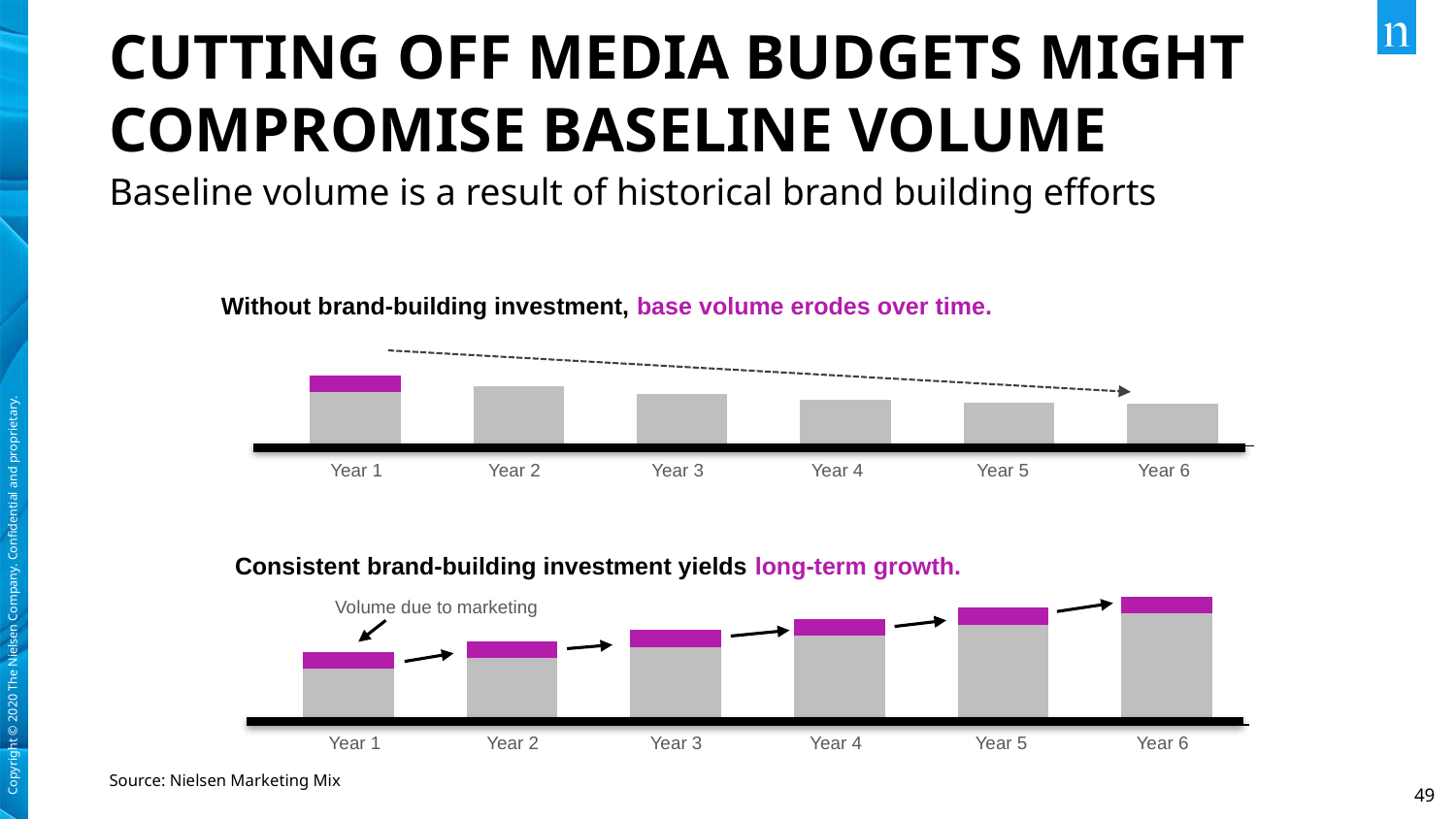
What kind of chart is the bottom chart, titled "Consistent brand-building investment yields long-term growth"? Bar chart In the bottom chart (consistent brand-building investment), do the bars rise or fall from Year 1 to Year 6? Rise In the top chart (without brand-building investment), which year has the tallest bar? Year 1 What kind of chart is the top chart, titled "Without brand-building investment, base volume erodes over time"? Bar chart In the bottom chart (consistent brand-building investment), what does the magenta segment on top of each bar represent? Volume due to marketing In the top chart (without brand-building investment), how many years are shown on the x axis? 6 In the bottom chart (consistent brand-building investment), which year has the shortest bar? Year 1 In the top chart (without brand-building investment), which year has the shortest bar? Year 6 In the bottom chart (consistent brand-building investment), which bar is taller, Year 2 or Year 5? Year 5 In the bottom chart (consistent brand-building investment), which year has the tallest bar? Year 6 In the bottom chart (consistent brand-building investment), how many bars are there? 6 In the top chart (without brand-building investment), do the bars rise or fall from Year 1 to Year 6? Fall